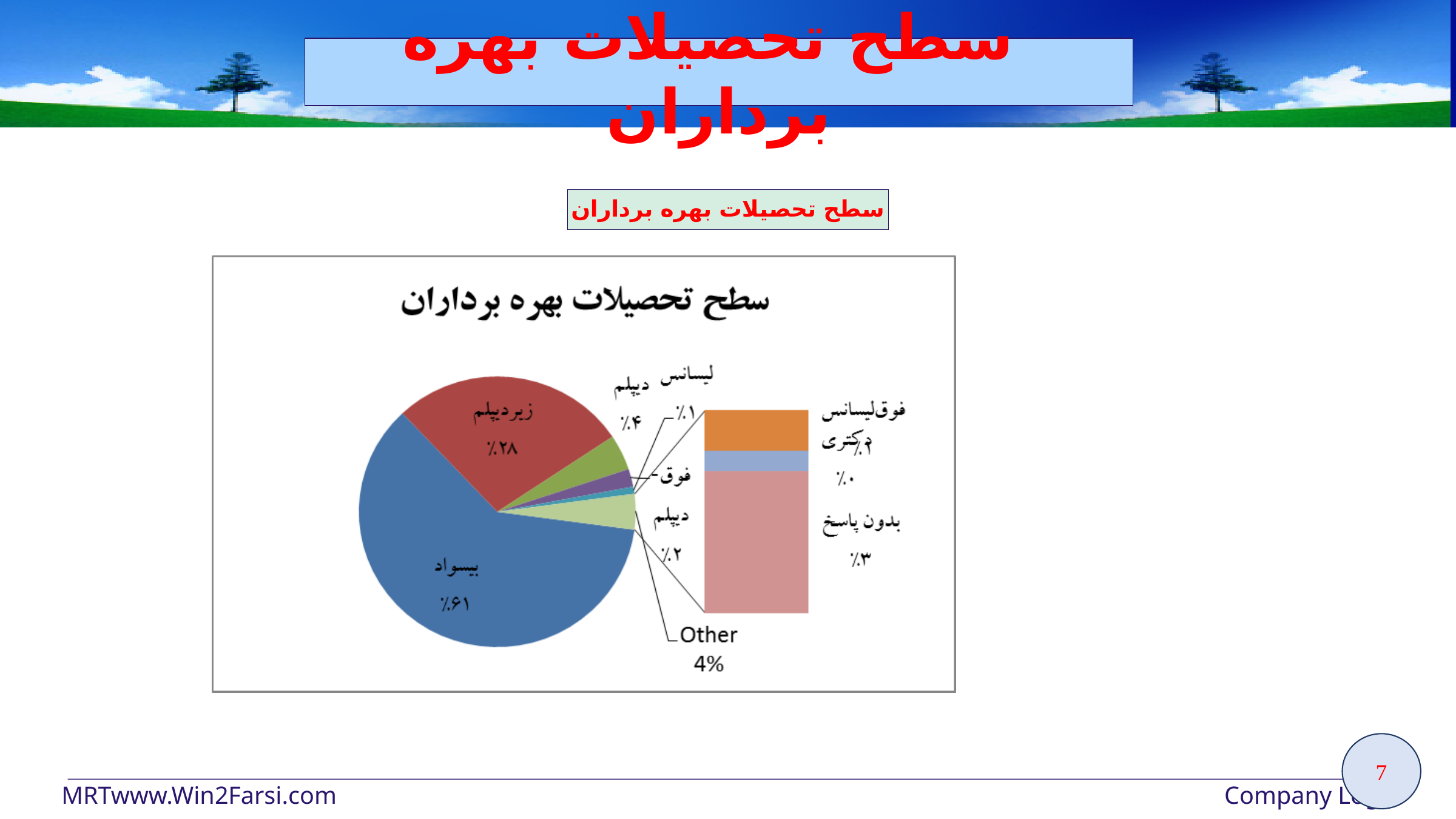
What is the value shown for the زیردیپلم slice? ۲۸٪ Which category has the largest share of the pie? بیسواد What is the value shown for the بیسواد slice? ۶۱٪ Which is larger, the زیردیپلم share or the فوق دیپلم share? زیردیپلم Which category in the breakout bar has the smallest value? دکتری What is the title of the chart? سطح تحصیلات بهره برداران What is the difference between the بیسواد and زیردیپلم shares? ۳۳٪ What percentage is labelled for the Other slice? 4% What is the value shown for بدون پاسخ in the breakout bar? ۳٪ What is the value shown for the دیپلم slice? ۲٪ What kind of chart is shown on the slide? Pie chart What is the value shown for the فوق دیپلم slice? ۴٪